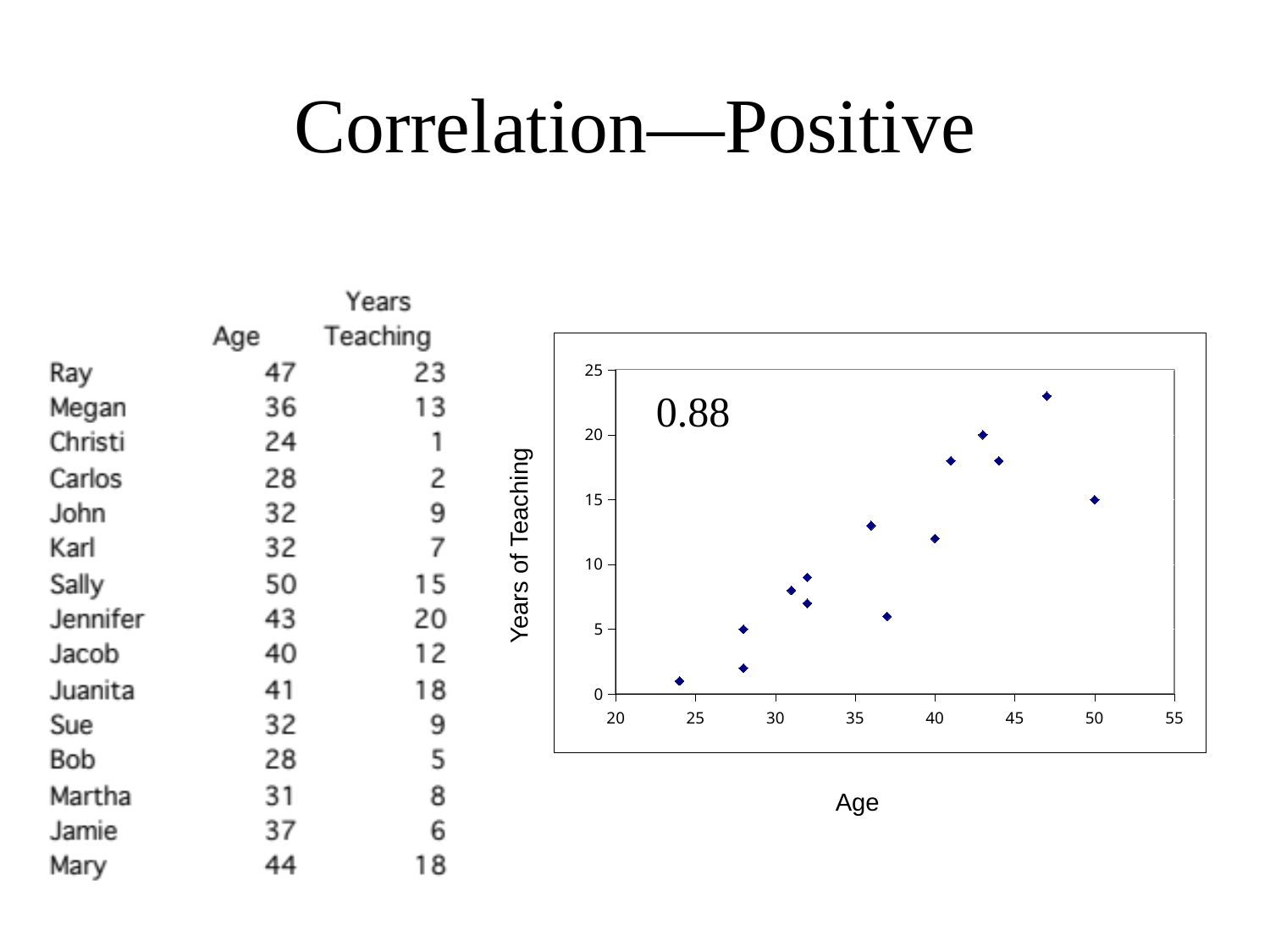
What is the label of the x axis of the chart? Age What is the highest value shown on the y axis of the chart? 25 At what age does the point with the highest years of teaching occur? 47 At what age does the point with the lowest years of teaching occur? 24 What is the label of the y axis of the chart? Years of Teaching Do the years of teaching generally rise or fall as age increases along the x axis? rise According to the table, how many years of teaching does Ray have? 23 Is the years-of-teaching value for the point at age 47 greater or less than 20? greater Which point has more years of teaching: the one at age 37 or the one at age 36? age 36 What kind of chart is shown on the slide? scatter plot Is the years-of-teaching value for the point at age 24 greater or less than 5? less Is the years-of-teaching value for the point at age 50 greater or less than 20? less